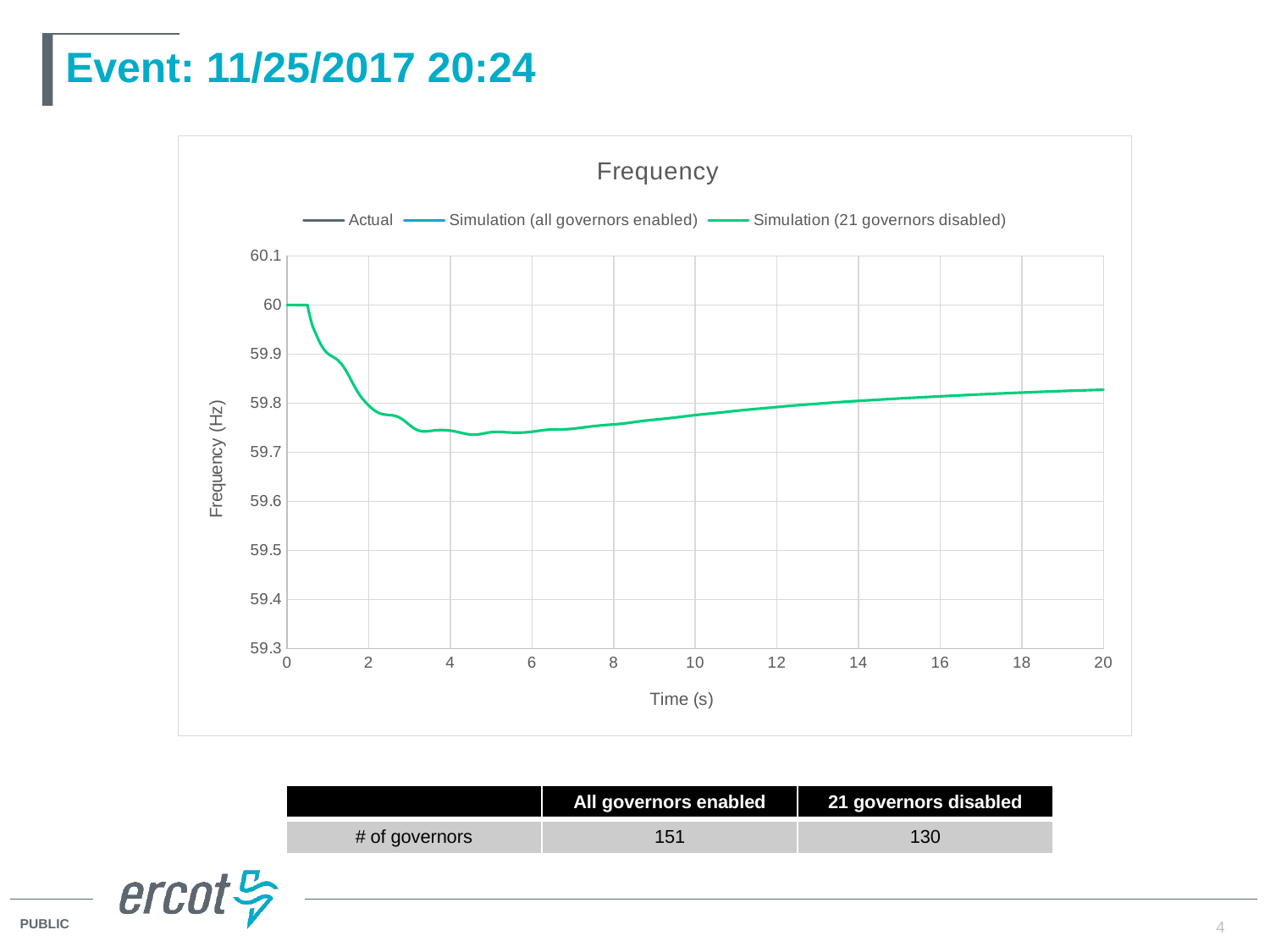
What is the label of the y axis? Frequency (Hz) What is the highest value shown on the y axis? 60.1 Is the frequency value at time 4 s greater or less than 59.7? greater Is the frequency value at time 16 s greater or less than 59.7? greater What is the title of the chart? Frequency Does the frequency rise or fall between time 6 s and time 20 s? rise How many series does the chart legend list? 3 Is the frequency value at time 2 s greater or less than 59.9? less What is the frequency value at time 0 s? 60 What kind of chart is shown on the slide? line chart Does the frequency rise or fall between time 0 s and time 4 s? fall